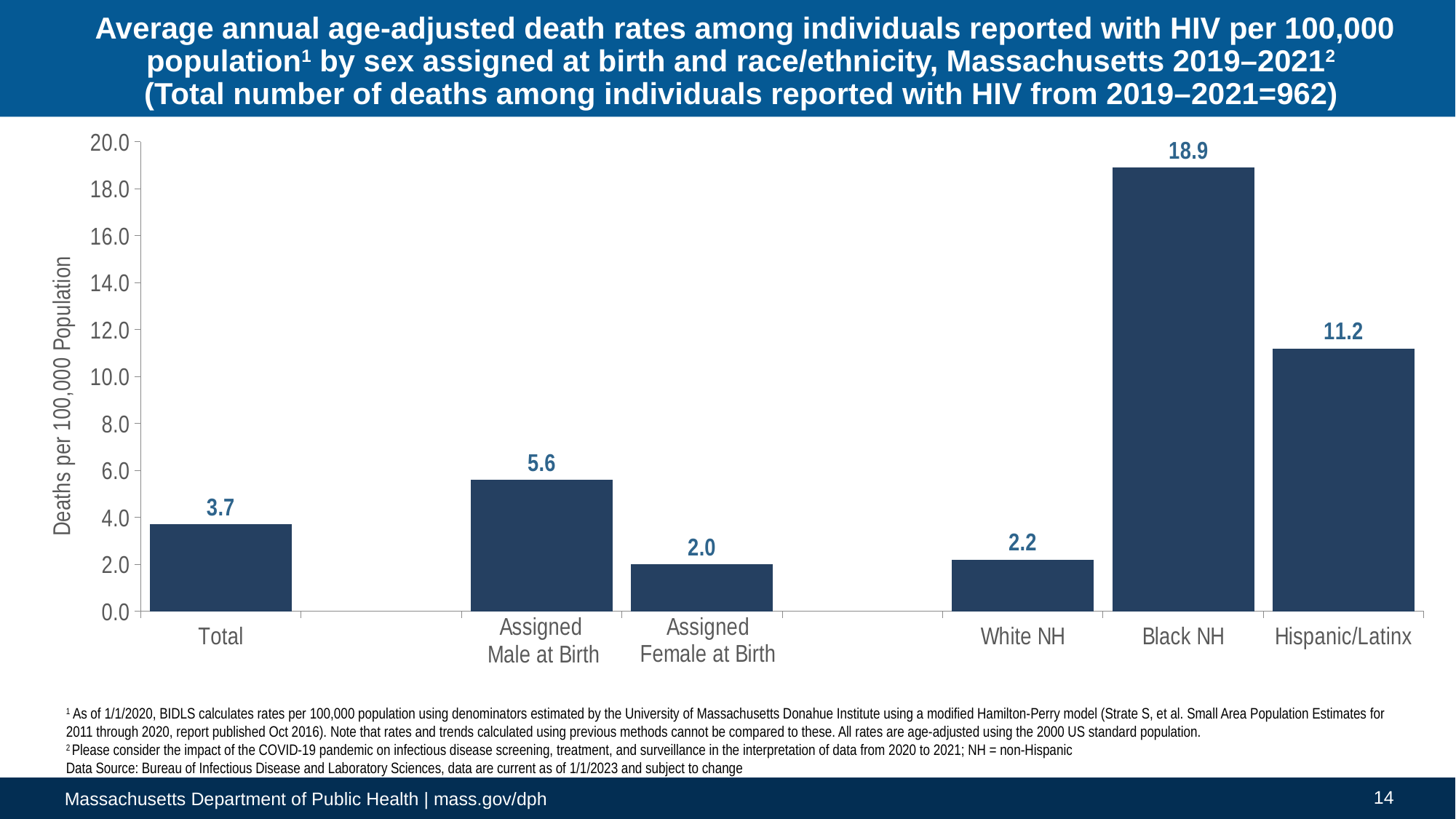
What is the death rate per 100,000 population for Hispanic/Latinx individuals? 11.2 What type of chart is shown on the slide? Bar chart What is the death rate per 100,000 population for the Total category? 3.7 What is the death rate per 100,000 population for individuals Assigned Male at Birth? 5.6 Which category has the lowest death rate? Assigned Female at Birth What is the death rate per 100,000 population for Black NH individuals? 18.9 What is the difference between the death rates for Black NH and Hispanic/Latinx individuals? 7.7 What is the difference between the death rates for individuals Assigned Male at Birth and Assigned Female at Birth? 3.6 Which category has the highest death rate? Black NH How many categories are shown in the chart? 6 Which has a higher death rate, White NH or Total? Total Is the death rate for Hispanic/Latinx individuals greater or less than 10.0? greater